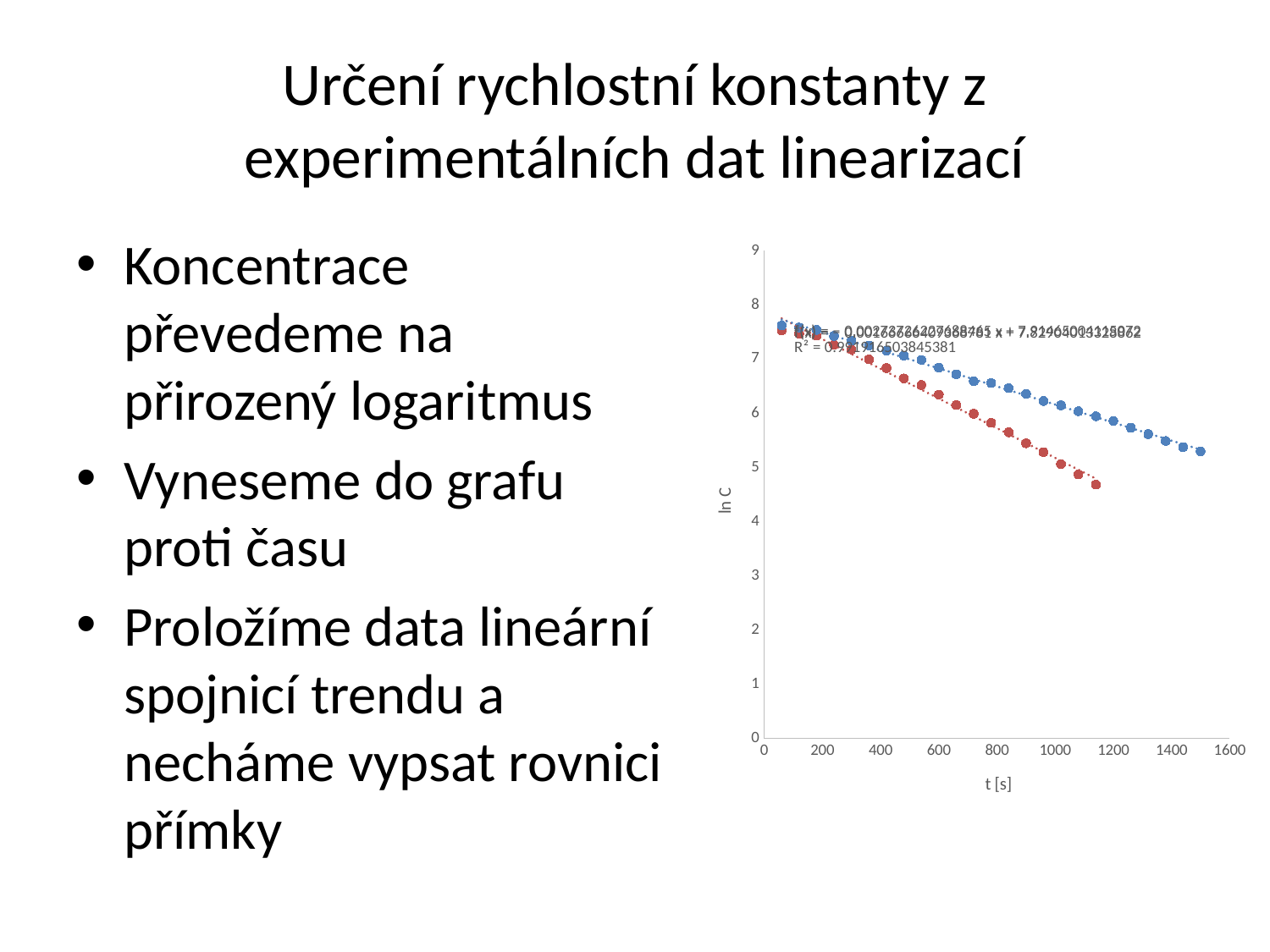
How many data series are plotted in the chart? 2 Is the value of the blue series at t = 1500 greater or less than 5? greater What is the label of the y axis of the chart? ln C Is the first value of the blue series (near t = 0) greater or less than 7? greater Which series decreases more steeply with time, the blue or the red? red Is the last value of the red series (near t = 1150) greater or less than 5? less At t = 1000, which series has the higher ln C value, the blue or the red? blue What is the highest tick value shown on the x axis? 1600 What kind of chart is shown on the slide? scatter chart Do the plotted values rise or fall as t increases along the x axis? fall What is the label of the x axis of the chart? t [s]